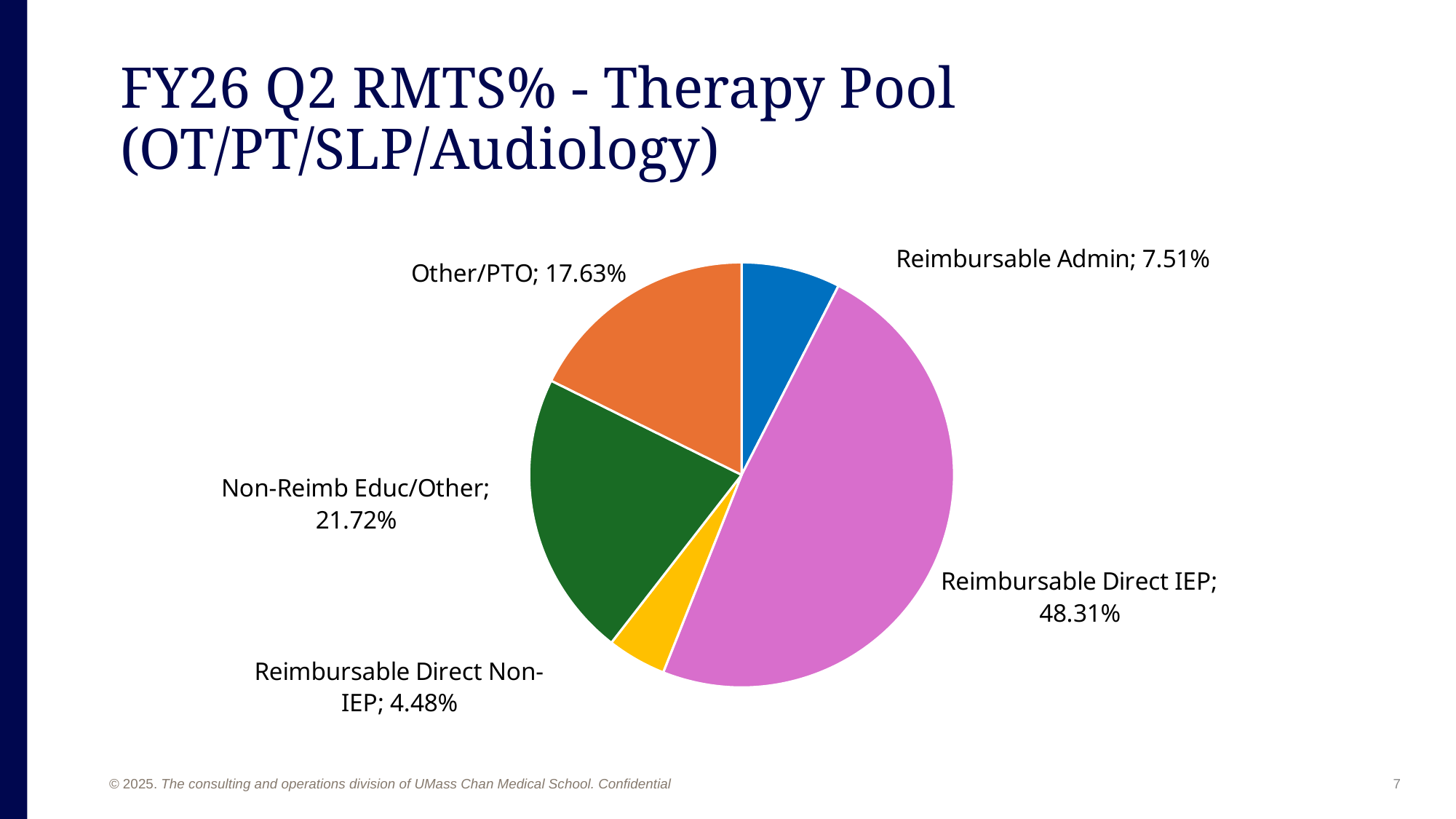
Which is larger, Reimbursable Admin or Reimbursable Direct Non-IEP? Reimbursable Admin What is the value for Reimbursable Admin? 7.51% What is the value for Reimbursable Direct IEP? 48.31% Which category has the largest share of the pie? Reimbursable Direct IEP What is the value for Non-Reimb Educ/Other? 21.72% Which category has the smallest share of the pie? Reimbursable Direct Non-IEP How many slices does the pie chart have? 5 What is the title of the chart on the slide? FY26 Q2 RMTS% - Therapy Pool (OT/PT/SLP/Audiology) What is the value for Reimbursable Direct Non-IEP? 4.48% What type of chart is shown on the slide? Pie chart What is the value for Other/PTO? 17.63% What is the difference between Non-Reimb Educ/Other and Other/PTO? 4.09%